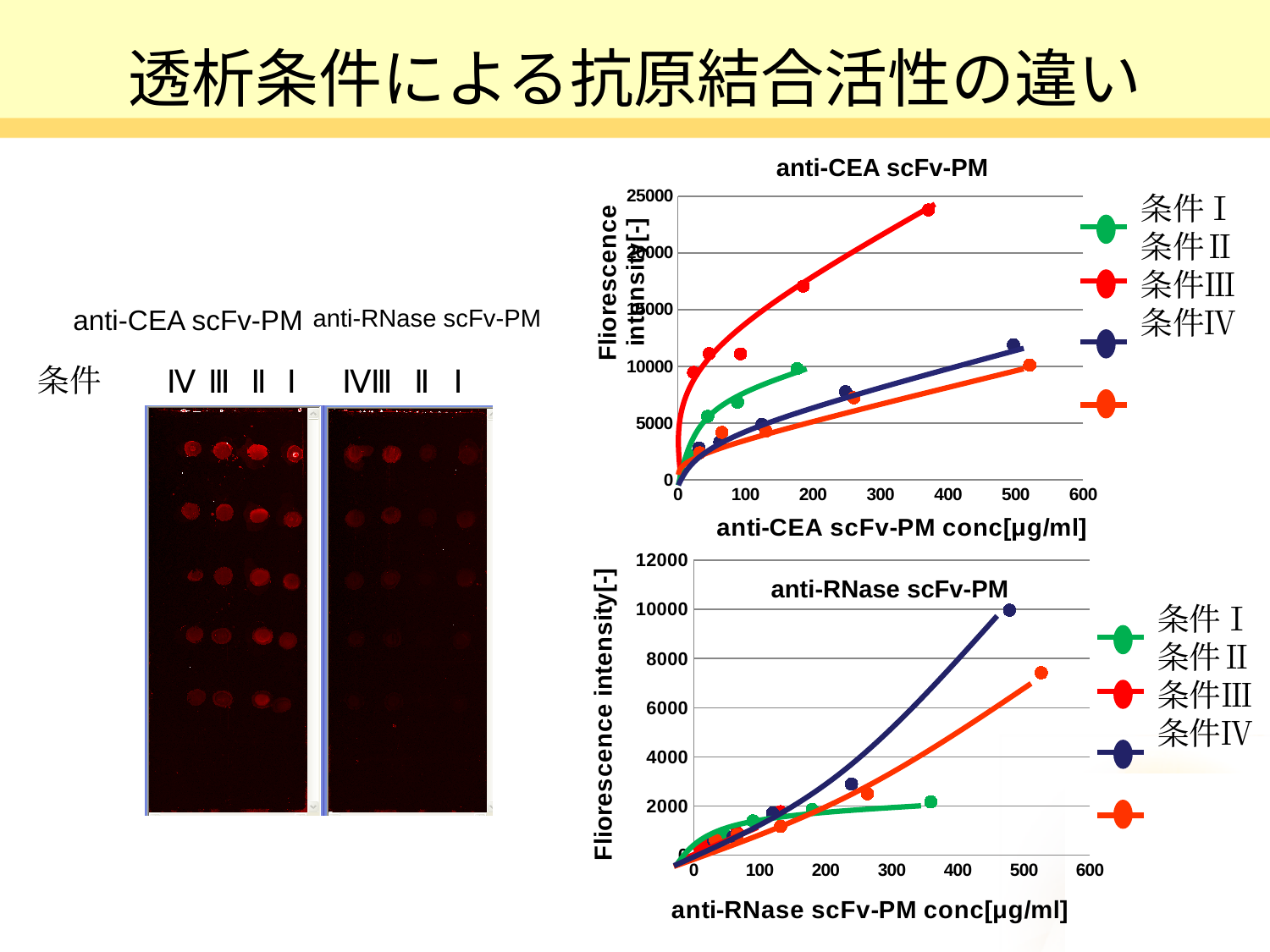
How many conditions (条件) does the legend of the anti-CEA scFv-PM chart list? 4 In the anti-CEA scFv-PM chart, which condition reaches the highest fluorescence intensity? 条件Ⅲ In the anti-RNase scFv-PM chart, which condition reaches the highest fluorescence intensity? 条件Ⅳ In the anti-RNase scFv-PM chart, do the fluorescence intensity values rise or fall as concentration increases? rise In the anti-RNase scFv-PM chart, is the highest value of the 条件Ⅰ (green) series greater or less than 4000? less In the anti-CEA scFv-PM chart, which is higher at around 500 μg/ml: the 条件Ⅳ (navy) series or the orange series? 条件Ⅳ (navy) What is the maximum value shown on the y-axis of the anti-CEA scFv-PM chart? 25000 In the anti-CEA scFv-PM chart, is the value of the 条件Ⅳ (navy) series at about 500 μg/ml greater or less than 10000? greater What kind of chart is the anti-CEA scFv-PM chart? Line chart with data points (scatter with fitted curves) In the anti-RNase scFv-PM chart, is the highest value of the 条件Ⅳ (navy) series greater or less than 8000? greater What is the x-axis label of the anti-RNase scFv-PM chart? anti-RNase scFv-PM conc[μg/ml]